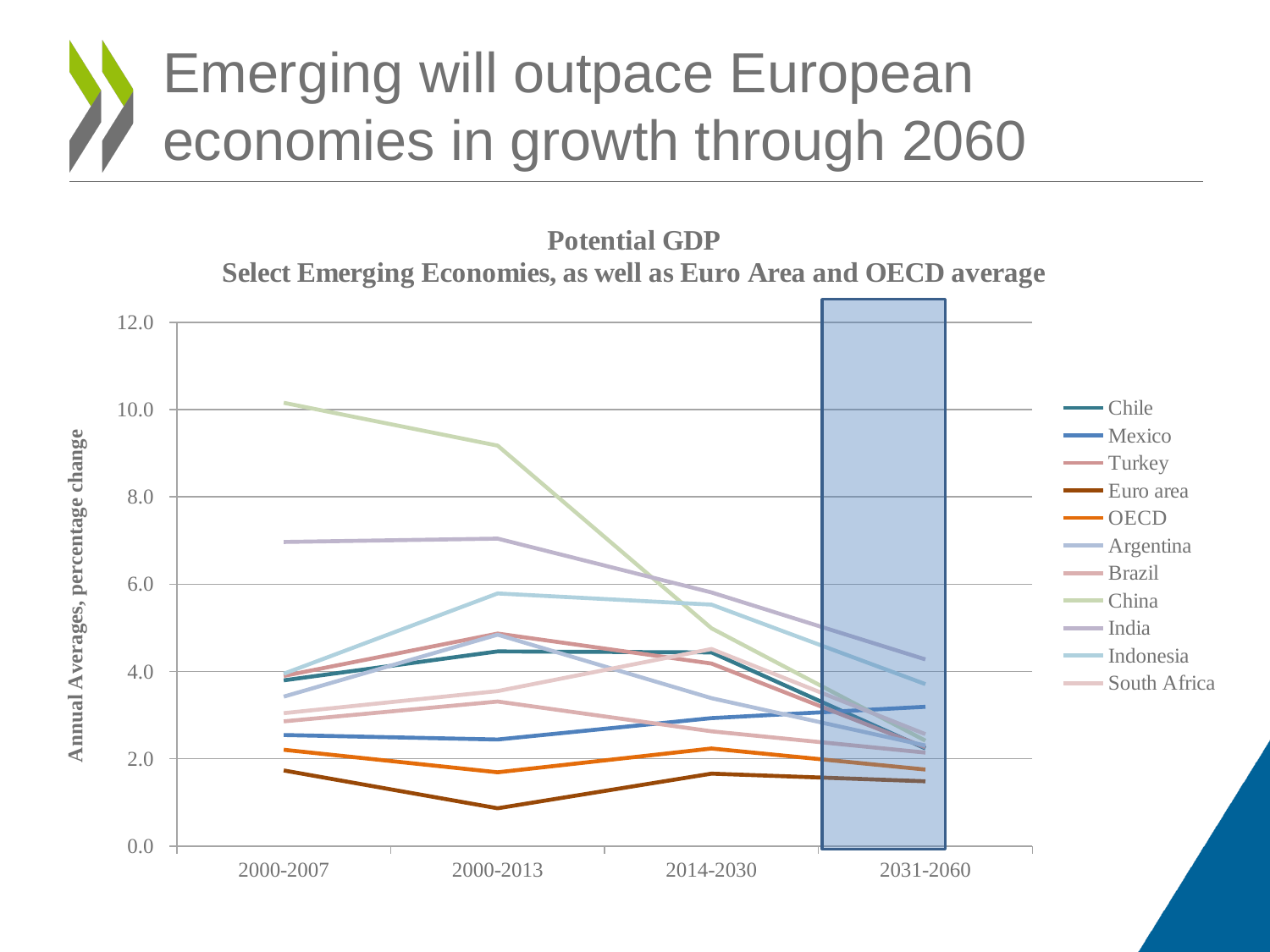
What is the label on the vertical axis? Annual Averages, percentage change What kind of chart is shown on the slide? Line chart Is the value for India in 2000-2007 greater or less than 6.0? greater How many time periods are shown along the x axis? 4 Which series has the lowest value in the 2000-2013 period? Euro area Is the value for China in 2000-2013 greater or less than 8.0? greater Which economy has the highest potential GDP growth in the 2000-2007 period? China Does the line for China rise or fall across the periods from 2000-2007 to 2031-2060? Falls Which economy has the highest value in the 2031-2060 period? India How many series does the legend list? 11 Is the value for the Euro area in 2031-2060 greater or less than 2.0? less In the 2014-2030 period, which is larger: the value for China or the value for India? India